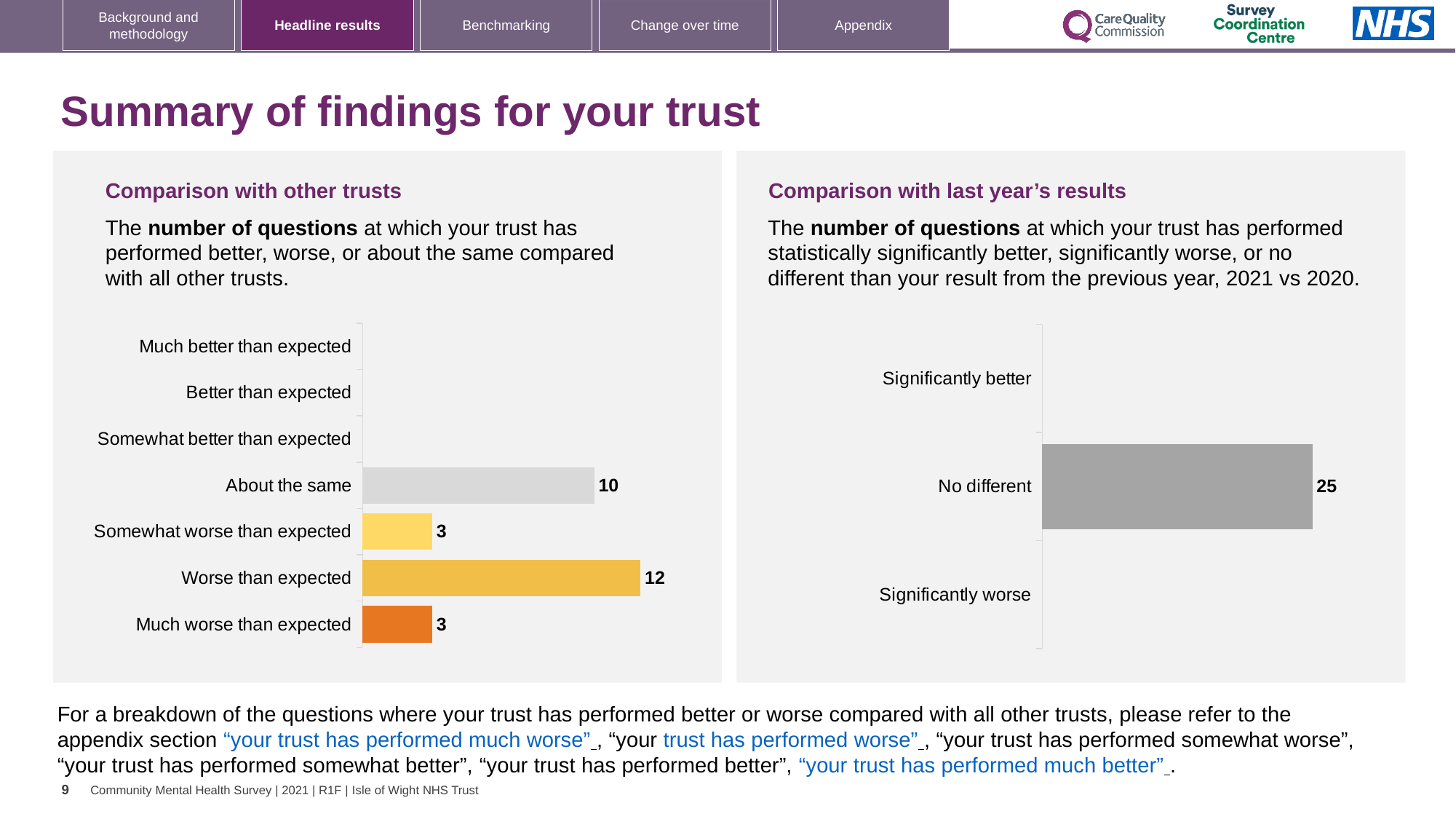
In the 'Comparison with other trusts' chart, what is the value for 'Much worse than expected'? 3 In the 'Comparison with other trusts' chart, which is larger: 'About the same' or 'Somewhat worse than expected'? About the same In the 'Comparison with other trusts' chart, what colour is the 'Much worse than expected' bar? Orange In the 'Comparison with other trusts' chart, how many categories are listed on the axis? 7 In the 'Comparison with other trusts' chart, how many questions are 'About the same'? 10 In the 'Comparison with other trusts' chart, which category has the highest value? Worse than expected What kind of chart is the 'Comparison with other trusts' chart? Bar chart In the 'Comparison with last year's results' chart, which category has the highest value? No different In the 'Comparison with other trusts' chart, what is the difference between 'Worse than expected' and 'About the same'? 2 In the 'Comparison with other trusts' chart, what is the value for 'Worse than expected'? 12 In the 'Comparison with last year's results' chart, how many categories are listed on the axis? 3 In the 'Comparison with last year's results' chart, what is the value for 'No different'? 25